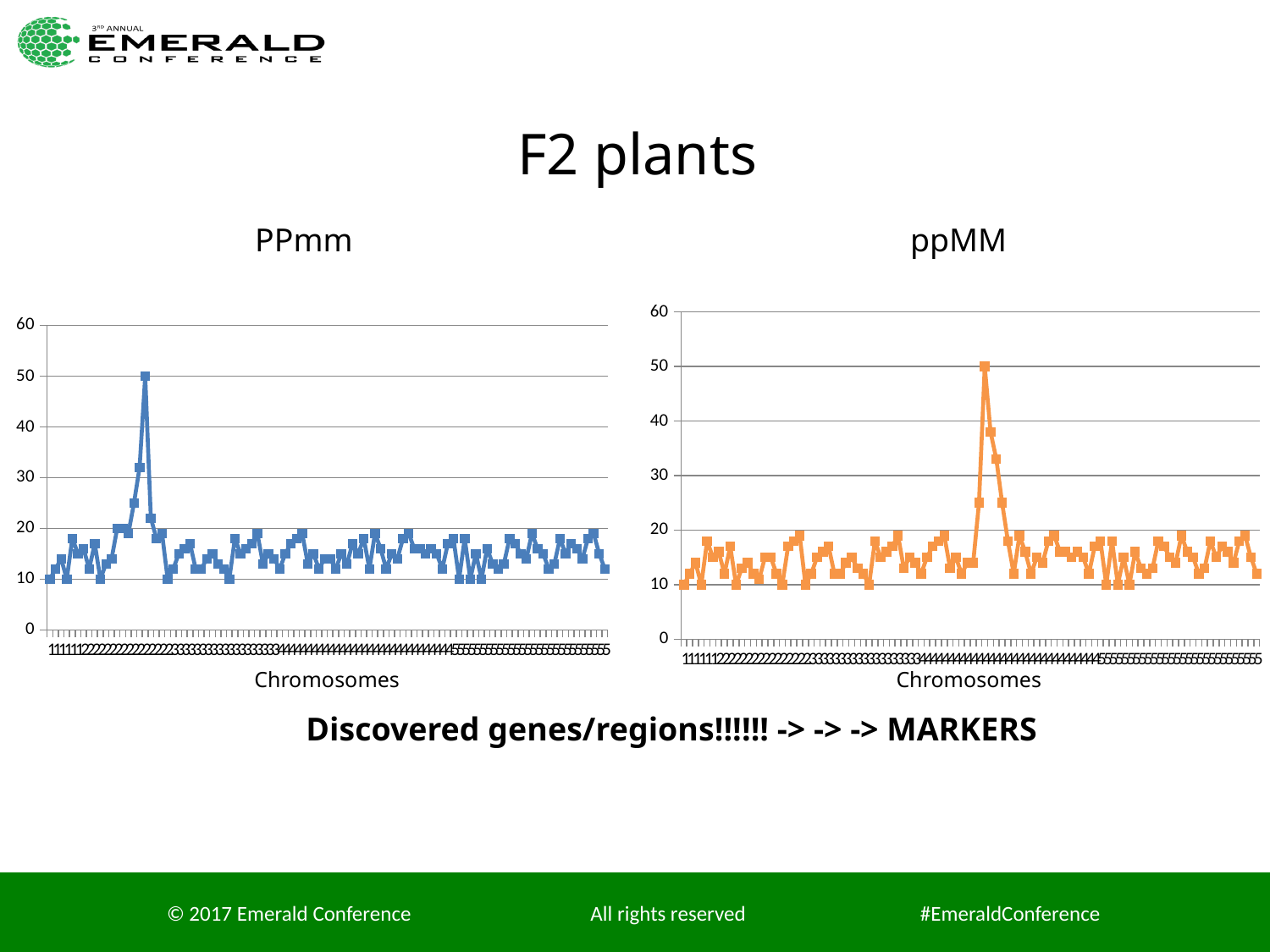
In the PPmm chart, is the peak value greater or less than 40? greater What kind of chart is the PPmm chart? line chart In the PPmm chart, what is the highest value reached by the line? 50 What is the x-axis title of the PPmm chart? Chromosomes What colour is the line in the ppMM chart? orange In the PPmm chart, which chromosome does the peak of the line fall on? Chromosome 2 In the PPmm chart, is the lowest value of the line greater or less than 20? less